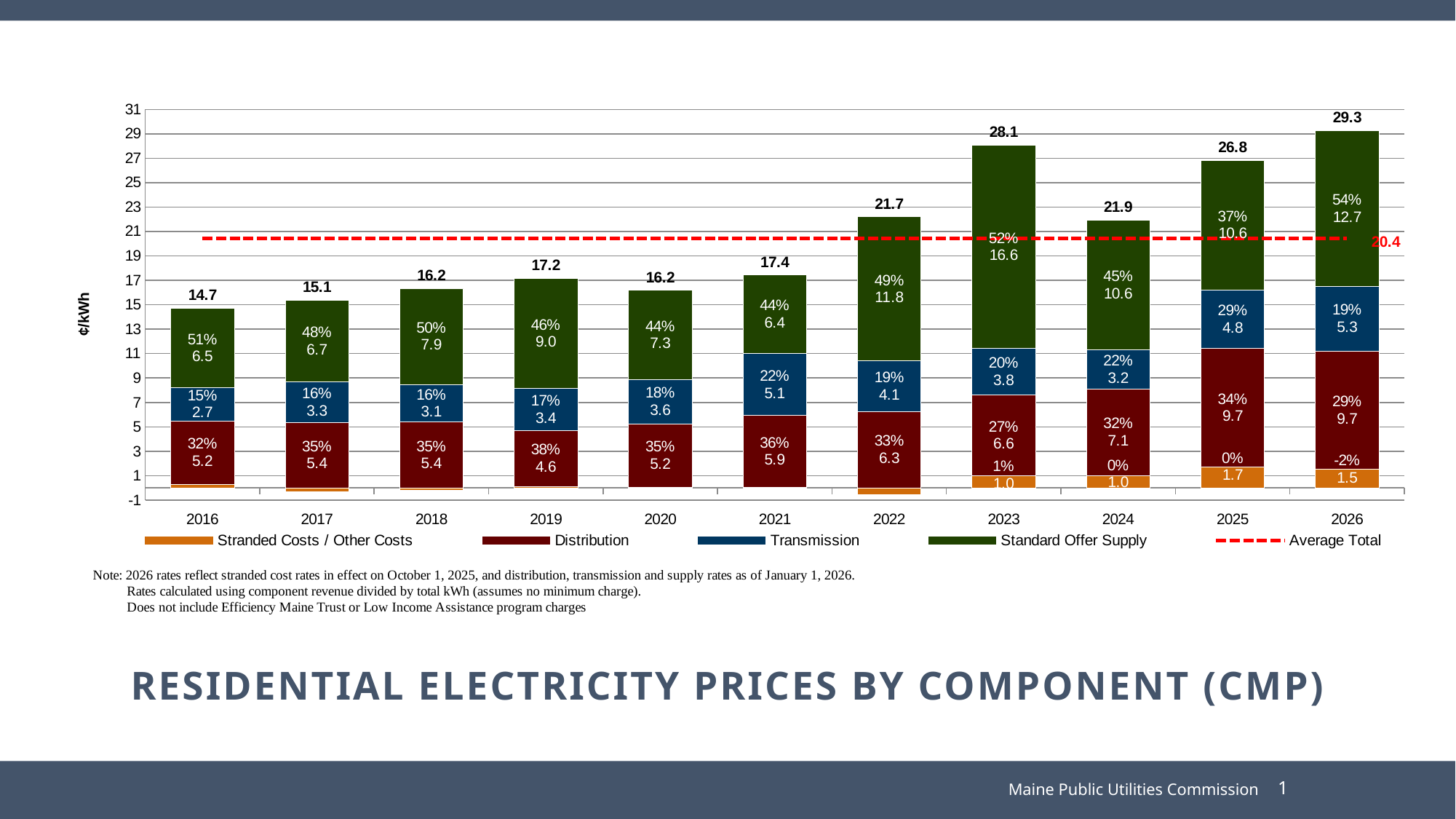
How many entries does the legend list? 5 How many years are shown on the x axis? 11 What value is labeled on the Average Total dashed line? 20.4 What unit is shown on the y axis? ¢/kWh Which year has the lowest total price? 2016 Which year has the larger Distribution value, 2024 or 2025? 2025 What percentage share does Transmission have in 2021? 22% What is the difference between the total for 2026 and the total for 2016? 14.6 What is the Standard Offer Supply value for 2023? 16.6 What kind of chart is shown on the slide? Stacked bar chart Which year has the highest total price? 2026 What is the total residential electricity price shown for 2023? 28.1